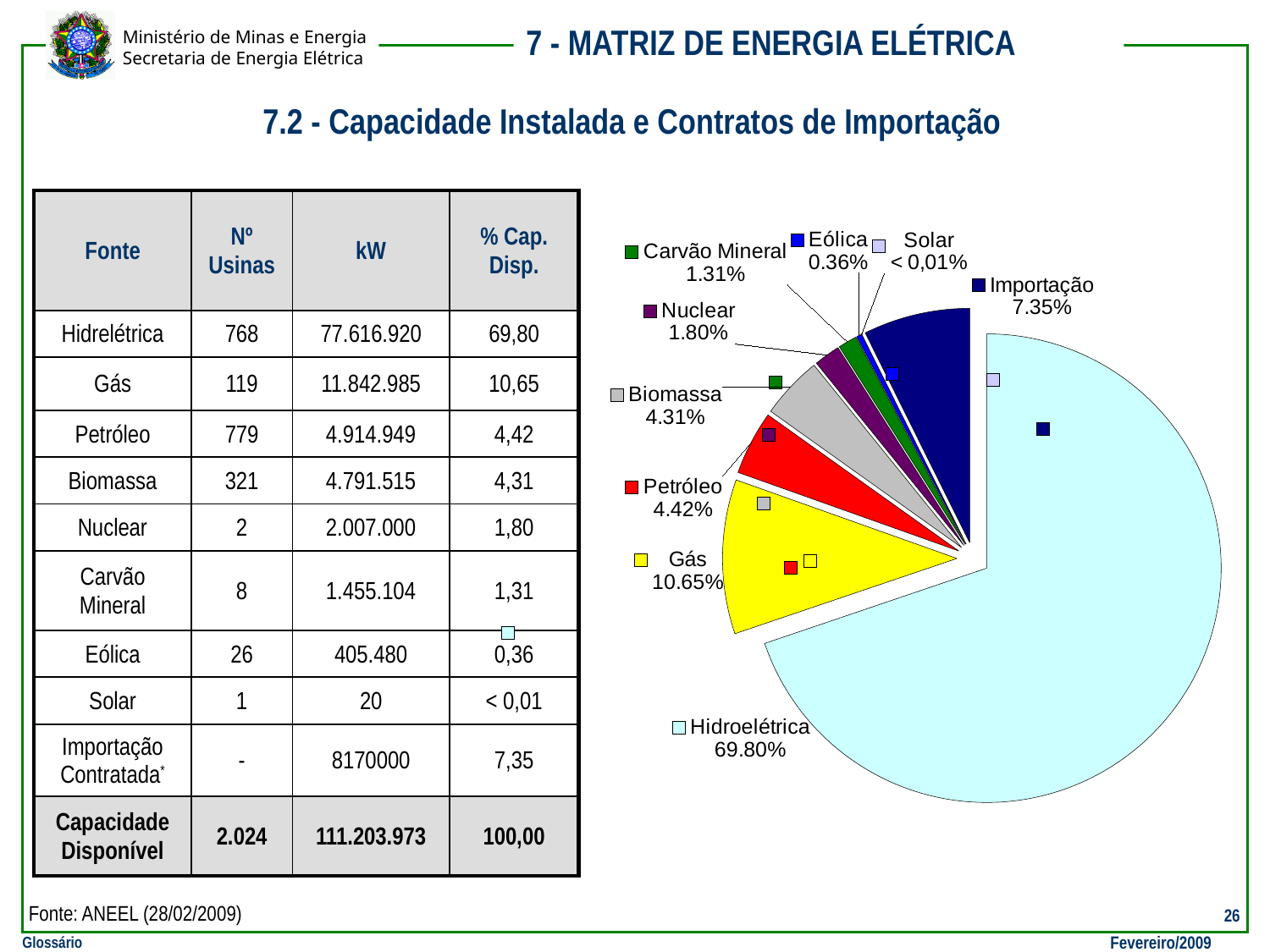
Which slice of the pie is the largest? Hidroelétrica What kind of chart is shown on the slide? pie chart What colour is the Hidroelétrica slice in the pie chart? light blue What is the difference in percentage points between the Gás and Importação slices? 3.30 How many slices does the pie chart have? 9 Which slice of the pie is the smallest? Solar Which is larger in the pie chart, Petróleo or Nuclear? Petróleo What share of the pie does Biomassa have? 4.31% What share of the pie does Gás have? 10.65% What share of the pie does Hidroelétrica have? 69.80% What share of the pie does Importação have? 7.35% What share of the pie does Eólica have? 0.36%